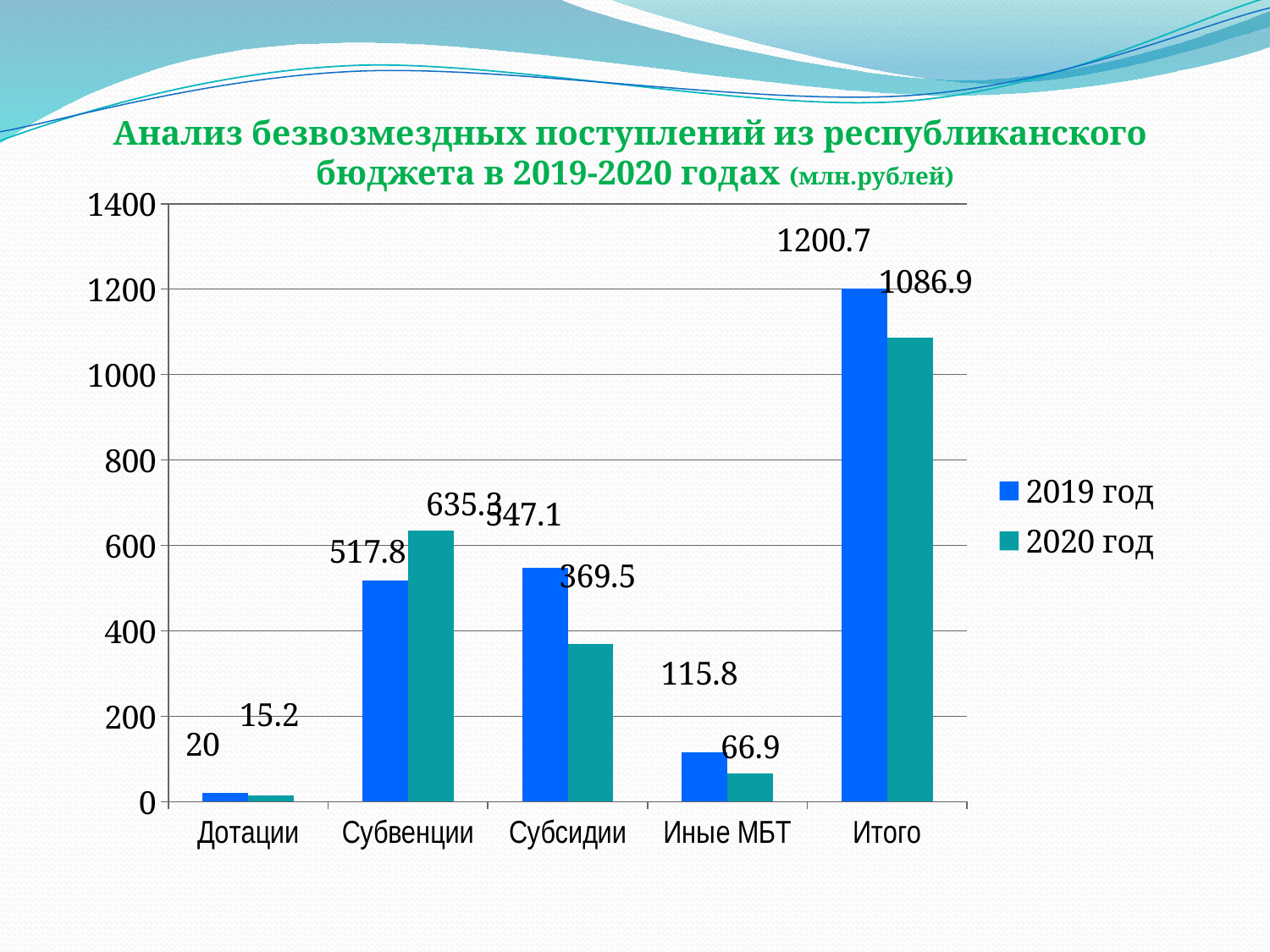
Which category has the highest value in the 2020 год series? Итого What is the difference between the 2019 год and 2020 год values for Итого? 113.8 How many categories are shown on the x axis? 5 What is the difference between the 2019 год and 2020 год values for Иные МБТ? 48.9 For Субвенции, which series has the larger value, 2019 год or 2020 год? 2020 год How many series does the legend list? 2 What is the value for Дотации in the 2020 год series? 15.2 What is the value for Иные МБТ in the 2019 год series? 115.8 Which category has the lowest value in the 2019 год series? Дотации What is the value for Итого in the 2019 год series? 1200.7 What is the value for Субсидии in the 2020 год series? 369.5 Is the 2020 год value for Субвенции greater or less than 600? greater